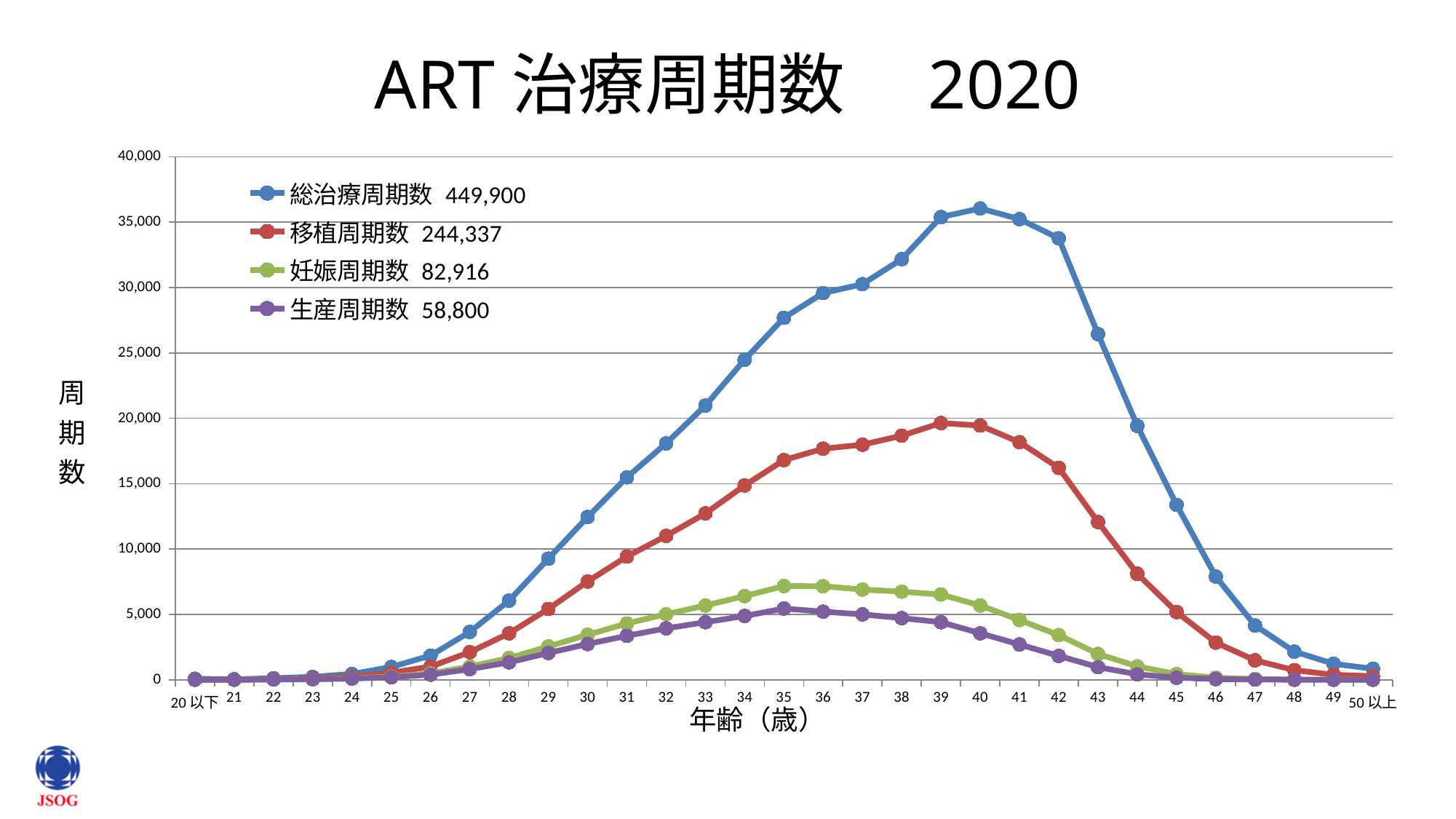
Is the value of 妊娠周期数 at age 35 greater or less than 10,000? less How many age categories are shown along the x axis? 31 How many series does the legend list? 4 Does the 総治療周期数 series rise or fall between age 42 and age 47? fall Is the value of 総治療周期数 at age 40 greater or less than 35,000? greater At which age does the 移植周期数 series reach its highest value? 39 Which series has the higher value at age 38, 移植周期数 or 妊娠周期数? 移植周期数 What total is printed in the legend for 生産周期数? 58,800 What total is printed in the legend for 移植周期数? 244,337 What total is printed in the legend for 総治療周期数? 449,900 At which age does the 総治療周期数 series reach its highest value? 40 What kind of chart is shown on the slide? line chart